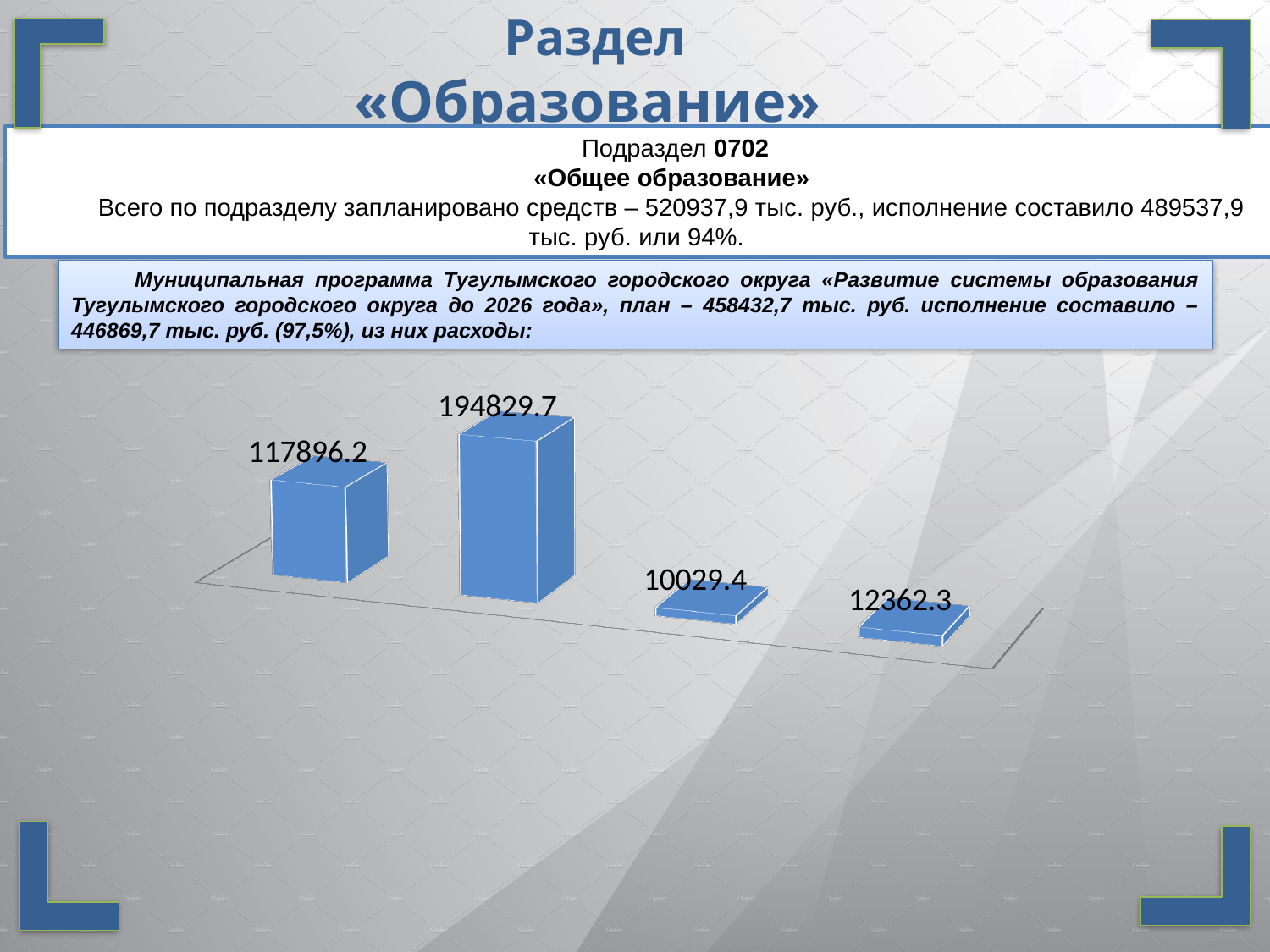
What is the difference between the fourth bar (12362.3) and the third bar (10029.4)? 2332.9 Which is larger, the value of the first bar or the value of the second bar? the second bar (194829.7) What is the difference between the second bar (194829.7) and the first bar (117896.2)? 76933.5 What is the value of the third bar from the left in the chart? 10029.4 What is the value of the first (leftmost) bar in the chart? 117896.2 What is the highest value shown in the chart? 194829.7 Which is larger, the value of the third bar or the value of the fourth bar? the fourth bar (12362.3) What kind of chart is shown on the slide? bar chart What is the lowest value shown in the chart? 10029.4 What is the value of the second bar from the left in the chart? 194829.7 What is the value of the fourth (rightmost) bar in the chart? 12362.3 How many bars does the chart show? 4